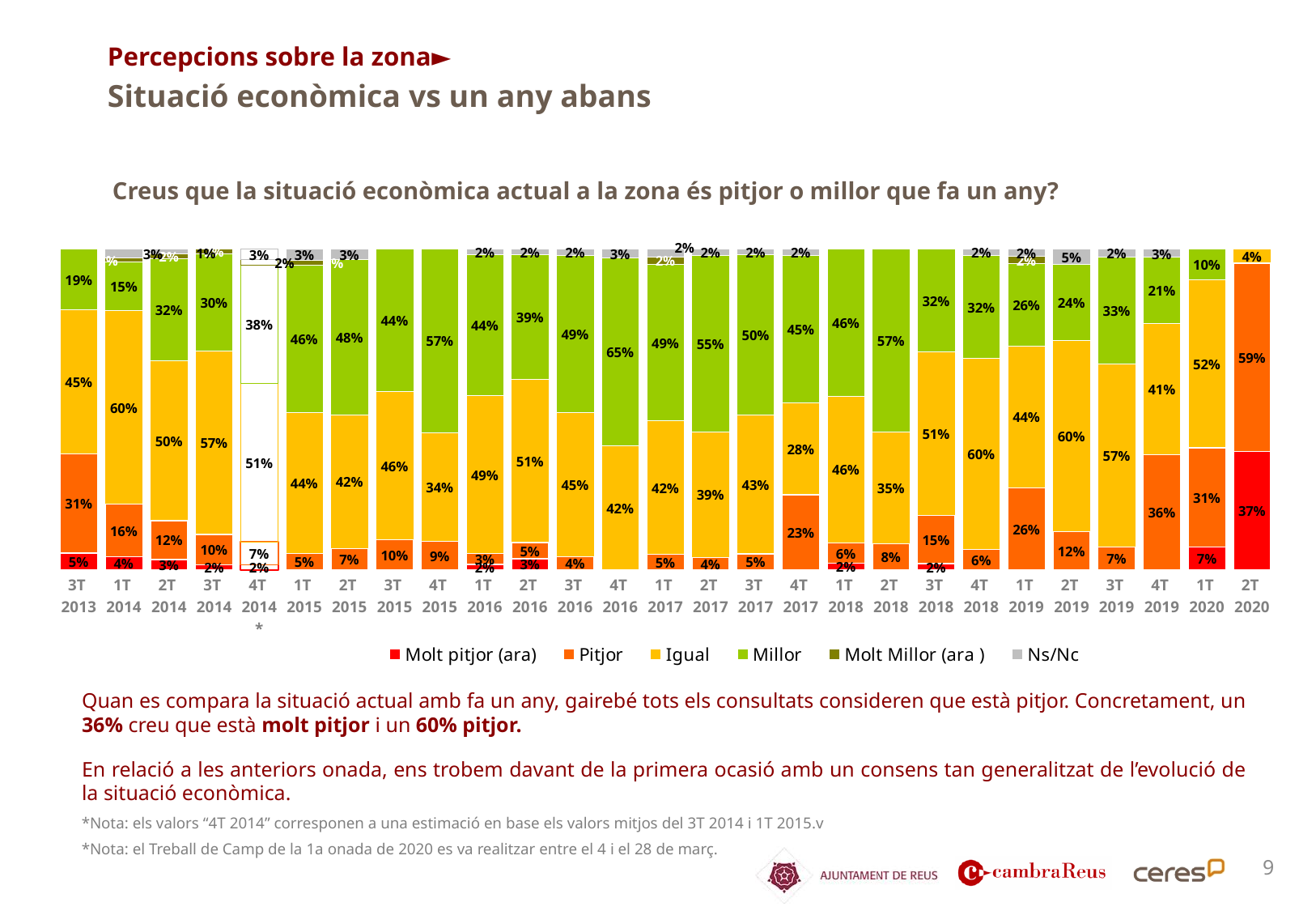
How many series does the legend list? 6 What is the value for 'Molt pitjor (ara)' in 2T 2020? 37% In which period is the 'Millor' share the highest? 4T 2016 What is the value for 'Millor' in 4T 2016? 65% What kind of chart is shown on the slide? Stacked bar chart Which colour represents the 'Millor' series in the chart? Green What is the value for 'Pitjor' in 4T 2017? 23% What is the value for 'Pitjor' in 2T 2020? 59% What is the value for 'Igual' in 1T 2014? 60% How many time periods (bars) are shown on the x axis? 27 Which period has the larger 'Igual' share, 4T 2018 or 4T 2019? 4T 2018